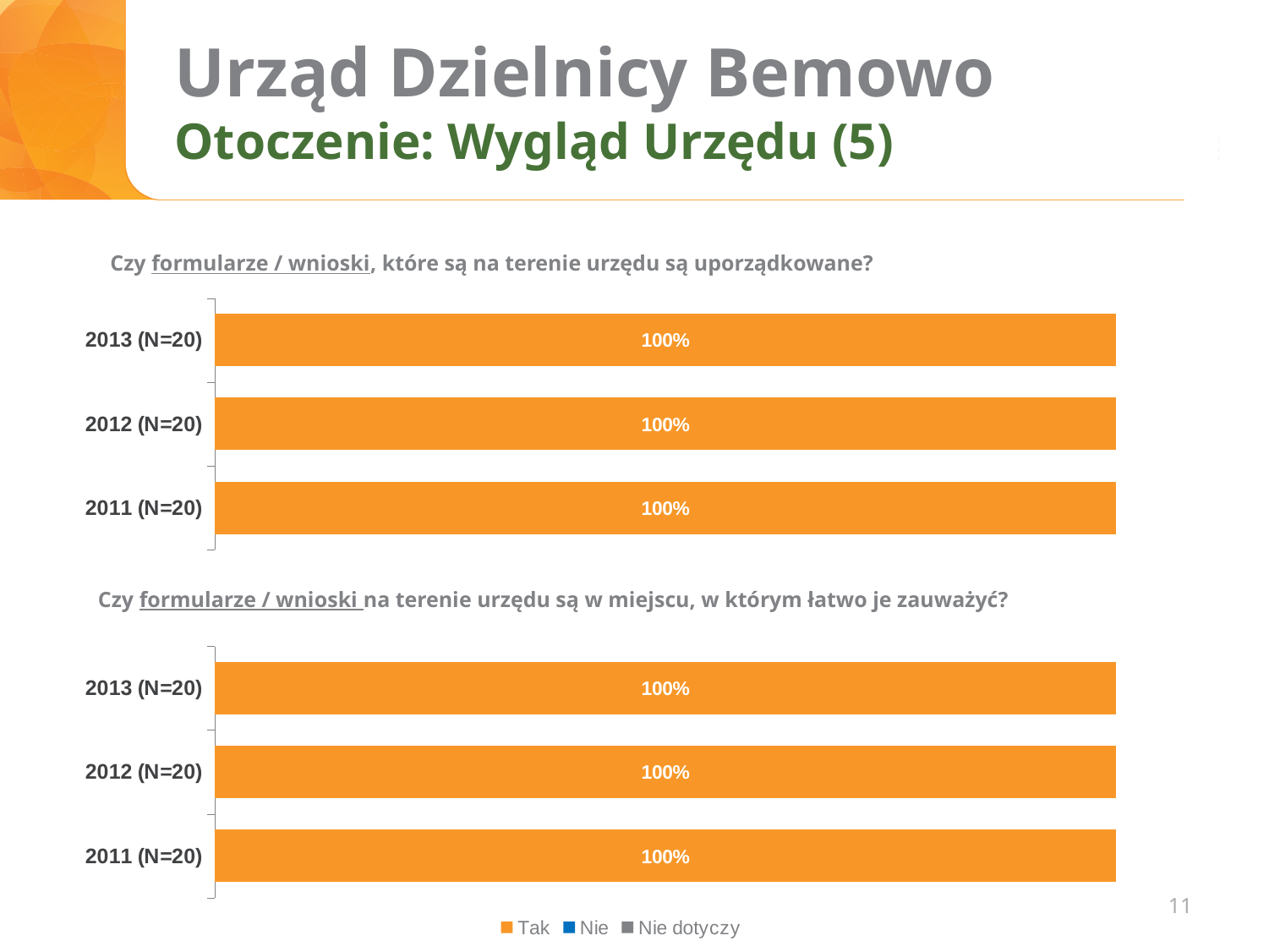
In the bottom chart, what is the difference between the values for 2012 (N=20) and 2011 (N=20)? 0% In the bottom chart ("Czy formularze / wnioski na terenie urzędu są w miejscu, w którym łatwo je zauważyć?"), what is the value for 2013 (N=20)? 100% How many categories (years) are shown in the bottom chart? 3 What kind of chart is the top chart? Bar chart In the top chart ("Czy formularze / wnioski, które są na terenie urzędu są uporządkowane?"), what is the value for 2011 (N=20)? 100% Do the values in the bottom chart rise, fall, or stay the same from 2011 (N=20) to 2013 (N=20)? Stay the same In the top chart, what is the difference between the values for 2013 (N=20) and 2011 (N=20)? 0% In the bottom chart ("Czy formularze / wnioski na terenie urzędu są w miejscu, w którym łatwo je zauważyć?"), what is the value for 2012 (N=20)? 100% How many categories (years) are shown in the top chart? 3 Which legend entry corresponds to the orange bars? Tak How many series does the legend at the bottom of the slide list? 3 In the top chart ("Czy formularze / wnioski, które są na terenie urzędu są uporządkowane?"), what is the value for 2013 (N=20)? 100%